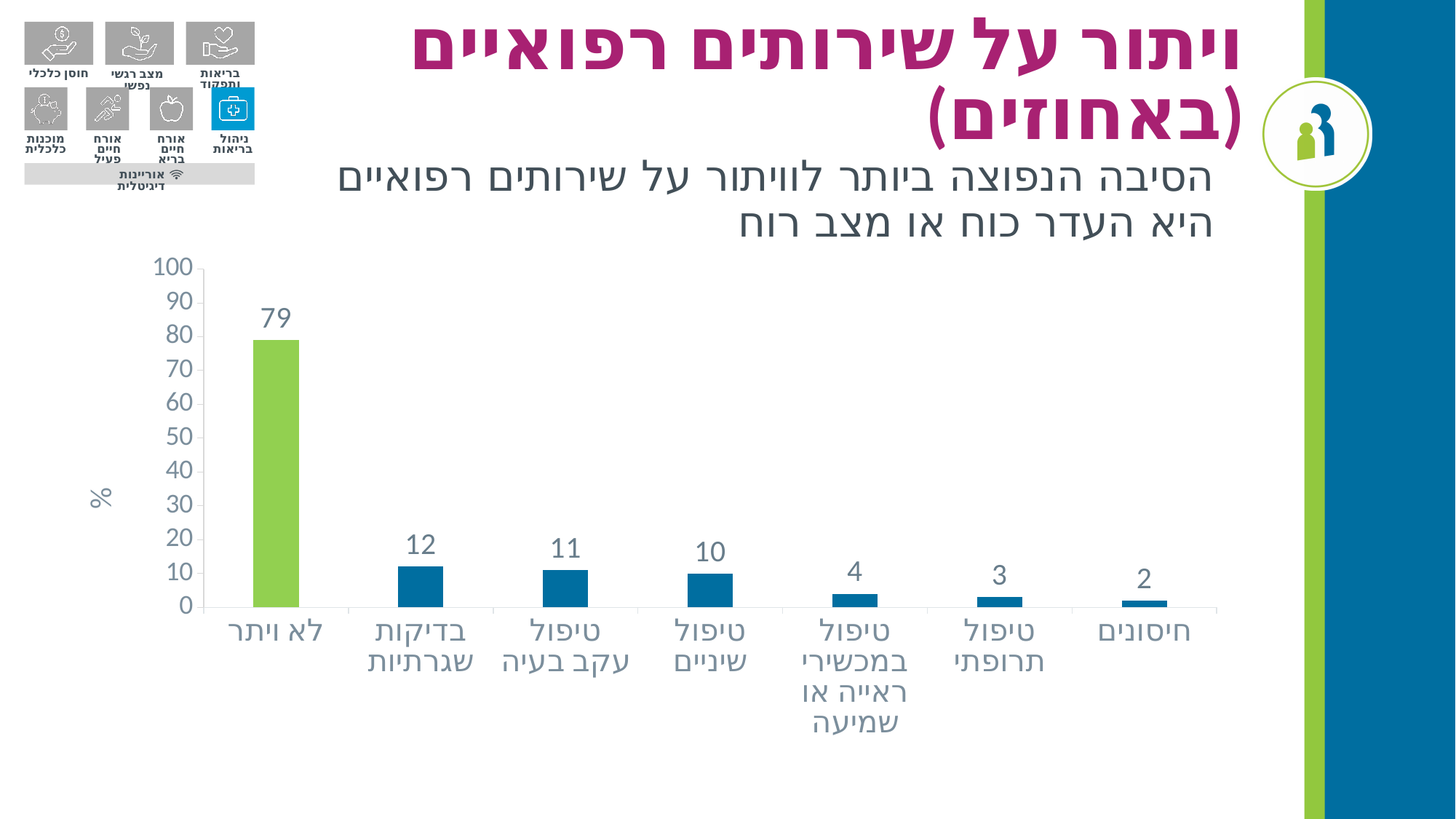
What is the difference between the values for "לא ויתר" and "בדיקות שגרתיות"? 67 How many categories are plotted in the chart? 7 What is the label on the vertical axis of the chart? % What is the value for "בדיקות שגרתיות"? 12 What is the value for "לא ויתר"? 79 Which category has the highest value? לא ויתר Is the value for "לא ויתר" greater or less than 70? greater What is the value for "טיפול שיניים"? 10 What kind of chart is shown on the slide? bar chart Which is larger, the value for "טיפול עקב בעיה" or the value for "טיפול תרופתי"? טיפול עקב בעיה Which category has the lowest value? חיסונים What is the value for "חיסונים"? 2